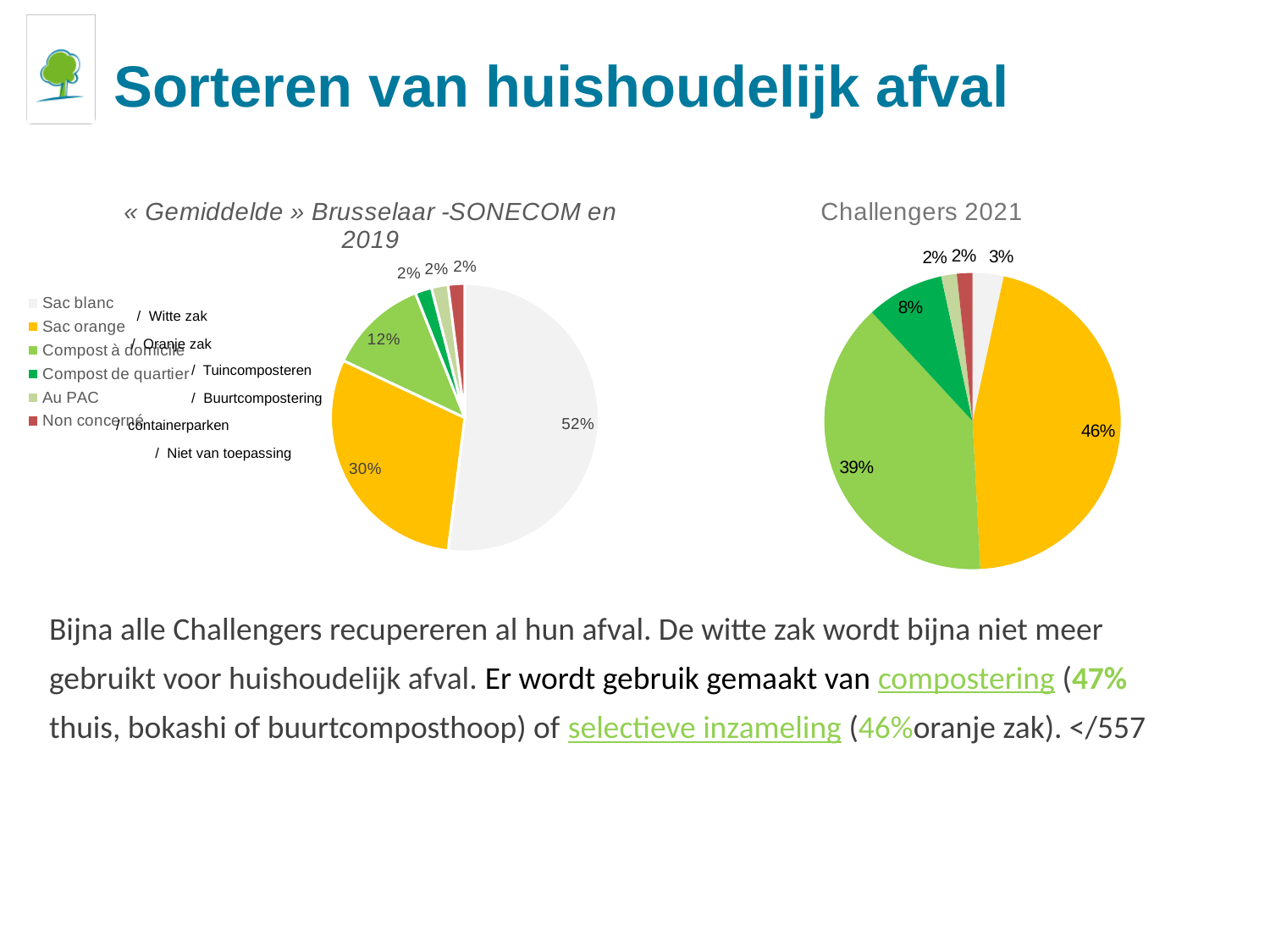
In the left chart (« Gemiddelde » Brusselaar - SONECOM en 2019), what share is shown for Sac orange? 30% In the Challengers 2021 chart, which category has the largest slice? Sac orange What is the difference between the Sac orange share in the Challengers 2021 chart and the Sac orange share in the left chart (SONECOM 2019)? 16 percentage points In the Challengers 2021 chart, what share is shown for Sac orange? 46% In the Challengers 2021 chart, what share is shown for Compost à domicile? 39% In the left chart (« Gemiddelde » Brusselaar - SONECOM en 2019), what share is shown for Compost à domicile? 12% In the Challengers 2021 chart, what share is shown for Compost de quartier? 8% How many categories does the shared legend list for the two pie charts? 6 Which is larger in the Challengers 2021 chart: the share for Compost à domicile or the share for Compost de quartier? Compost à domicile In the left chart (« Gemiddelde » Brusselaar - SONECOM en 2019), what share is shown for Sac blanc? 52% In the left chart (« Gemiddelde » Brusselaar - SONECOM en 2019), which category has the largest slice? Sac blanc What type of chart is used for the Challengers 2021 data? Pie chart